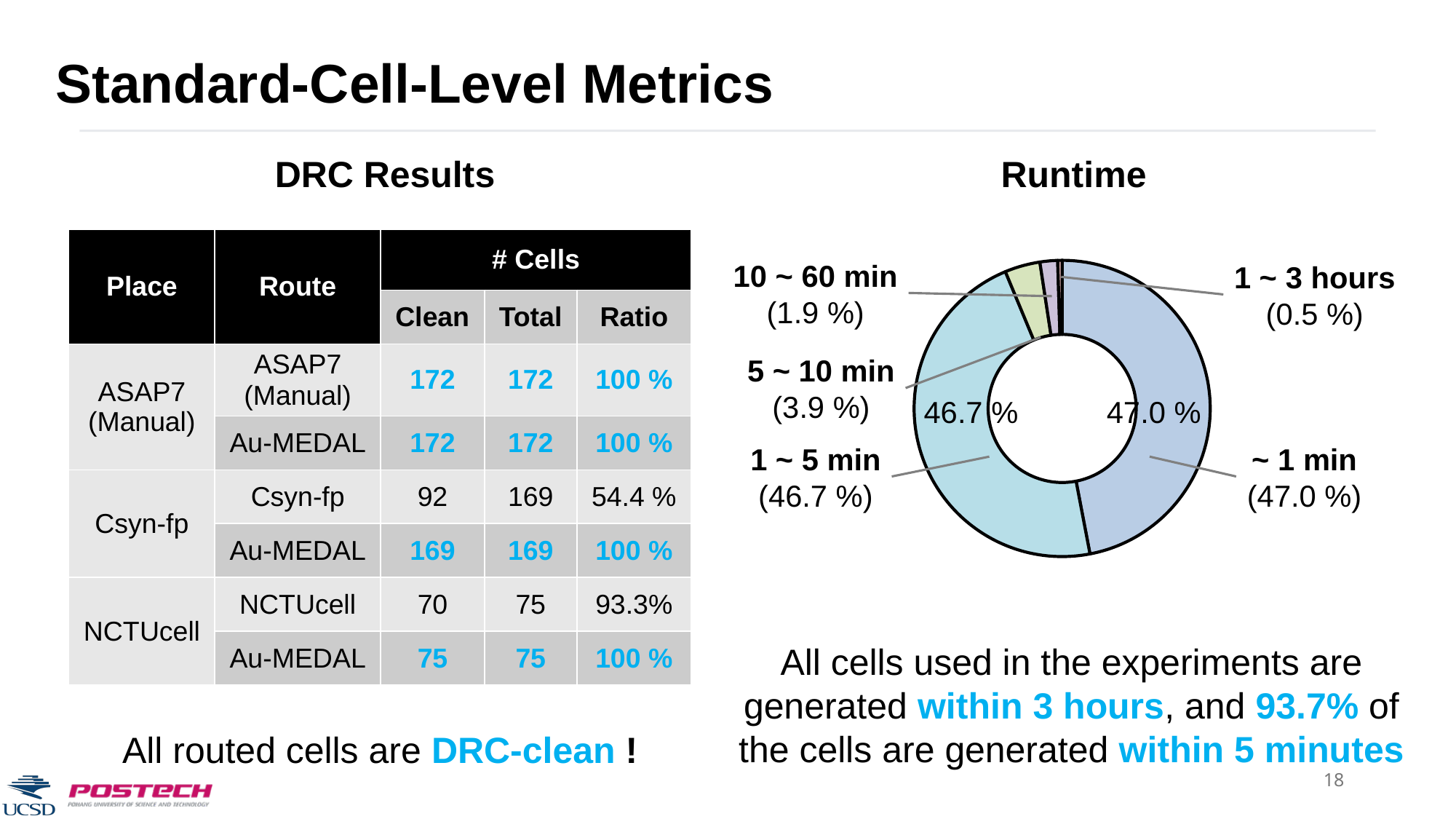
In the Runtime donut chart, what percentage is shown for the 1 ~ 5 min slice? 46.7 % In the Runtime donut chart, what percentage is shown for the 1 ~ 3 hours slice? 0.5 % How many slices does the Runtime donut chart have? 5 In the Runtime donut chart, what share of cells are generated in ~ 1 min? 47.0 % In the Runtime donut chart, what is the combined share of the ~ 1 min and 1 ~ 5 min slices? 93.7 % In the Runtime donut chart, which runtime range has the largest share? ~ 1 min In the Runtime donut chart, which runtime range has the smallest share? 1 ~ 3 hours In the Runtime donut chart, what percentage is shown for the 5 ~ 10 min slice? 3.9 % In the Runtime donut chart, what is the difference between the ~ 1 min share and the 1 ~ 5 min share? 0.3 % What kind of chart is used to show Runtime on the slide? donut chart In the Runtime donut chart, which slice is larger: 5 ~ 10 min or 10 ~ 60 min? 5 ~ 10 min In the Runtime donut chart, what percentage is shown for the 10 ~ 60 min slice? 1.9 %